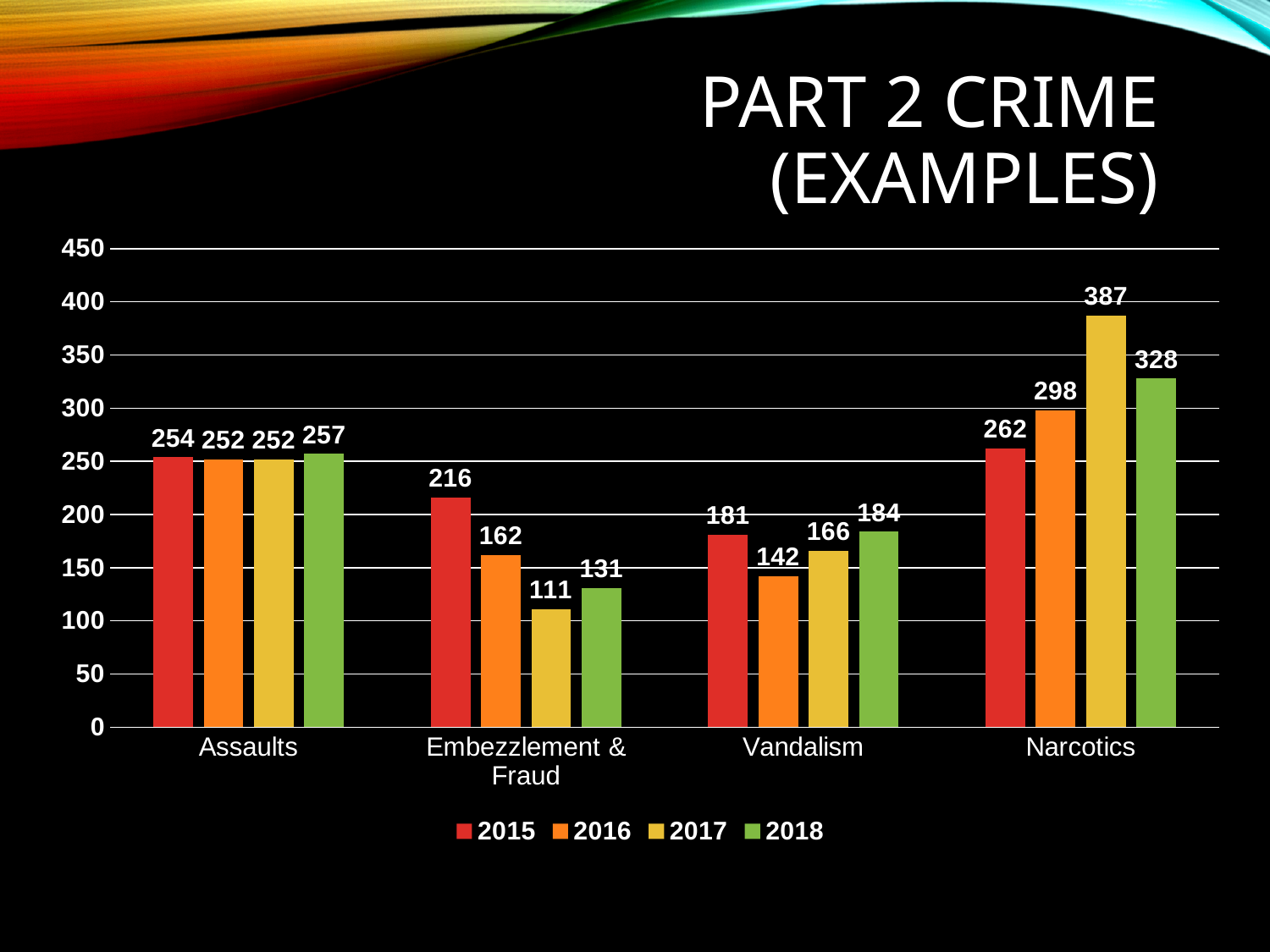
What is the value for Embezzlement & Fraud in 2015? 216 Which category has the highest value in 2018? Narcotics How many categories are shown on the x axis? 4 Do the values for Embezzlement & Fraud rise or fall from 2015 to 2017? Fall How many series does the legend list? 4 What is the value for Narcotics in 2017? 387 Which category has the lowest value in 2017? Embezzlement & Fraud Is the value for Vandalism in 2018 greater or less than 150? greater What kind of chart is shown on the slide? Bar chart Which is larger: the 2015 value for Assaults or the 2015 value for Narcotics? Narcotics What is the difference between the 2017 and 2018 values for Narcotics? 59 What is the value for Vandalism in 2016? 142